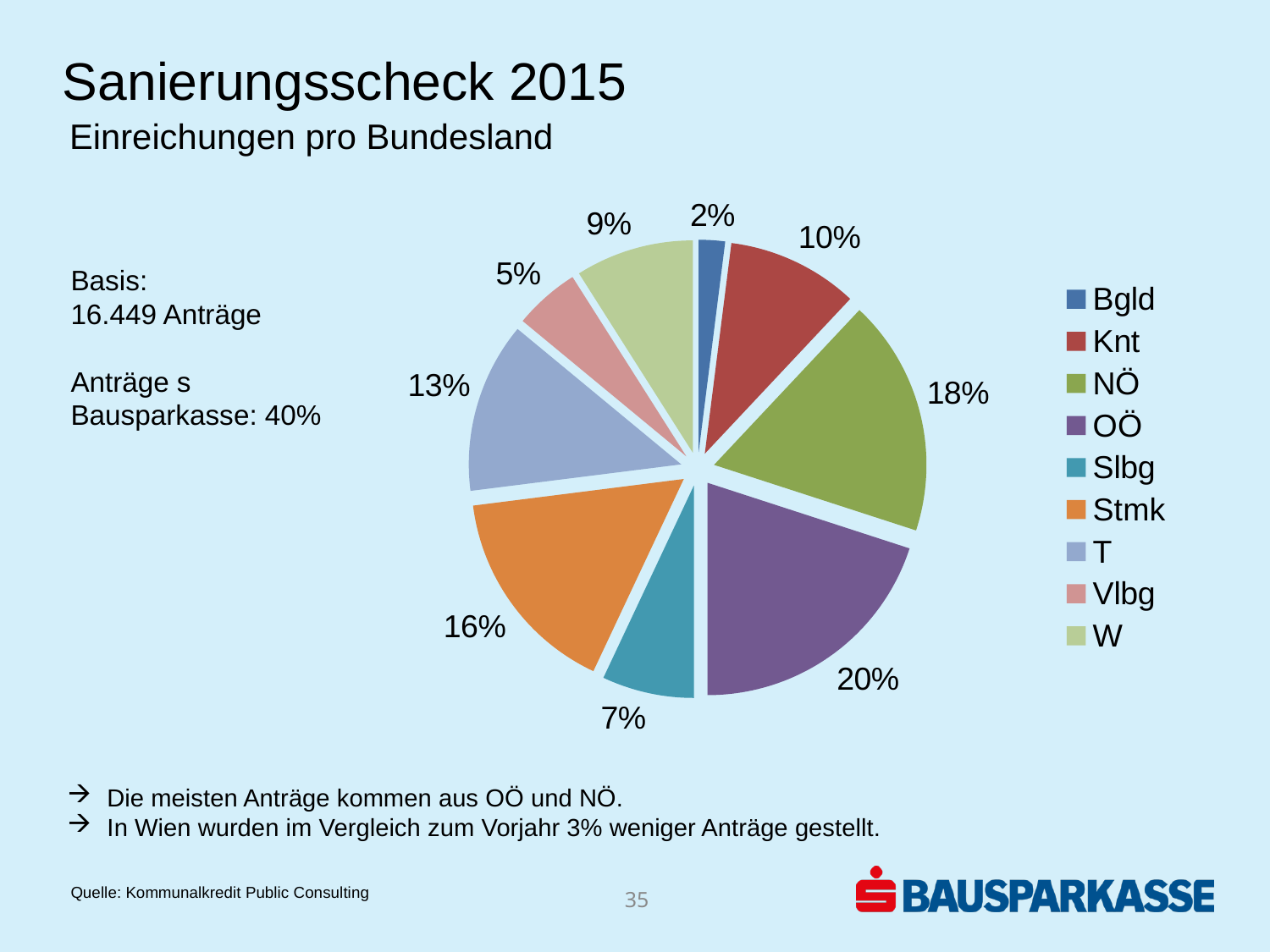
What share of the pie does NÖ have? 18% Which Bundesland has the smallest slice of the pie? Bgld What share of the pie does Stmk have? 16% What share of the pie does OÖ have? 20% How many slices does the pie chart have? 9 What share of the pie does W have? 9% How many entries does the legend list? 9 Which Bundesland has the largest slice of the pie? OÖ What share of the pie does Bgld have? 2% What is the difference in percentage points between the shares of OÖ and Knt? 10 What kind of chart is shown on the slide? pie chart Which has the larger share, T or Slbg? T